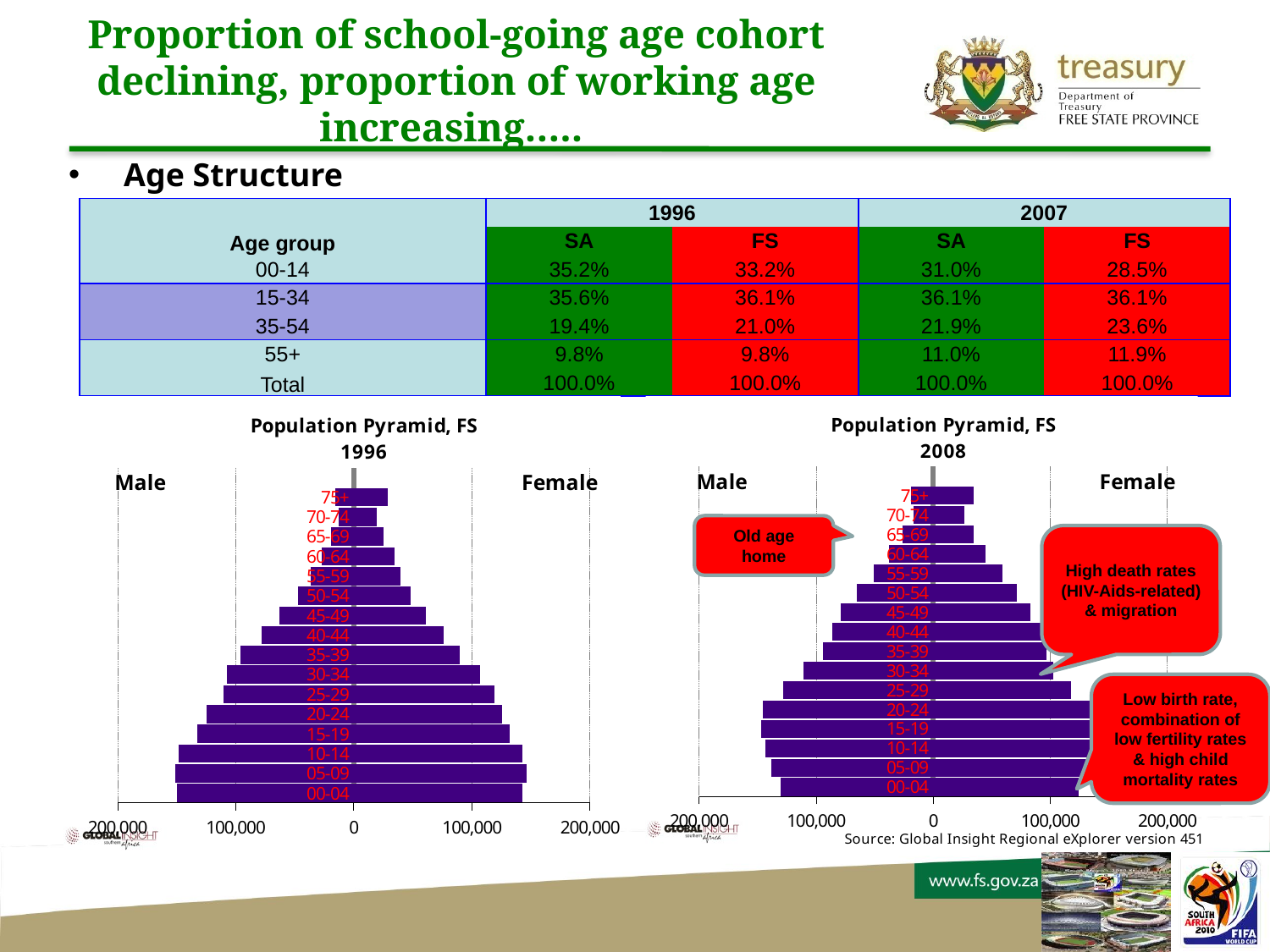
What kind of chart is the 'Population Pyramid, FS 1996' chart? bar chart In the 'Population Pyramid, FS 1996' chart, do the bar lengths generally rise or fall when moving from the youngest age group to the oldest? fall In the 'Population Pyramid, FS 2008' chart, which is larger: the female bar for 10-14 or the female bar for 65-69? 10-14 In the 'Population Pyramid, FS 2008' chart, is the female value for the 60-64 age group greater or less than 100,000? less How many age-group categories does the 'Population Pyramid, FS 2008' chart show? 16 In the 'Population Pyramid, FS 1996' chart, which age group has the shortest bars? 70-74 In the 'Population Pyramid, FS 1996' chart, is the male value for the 00-04 age group greater or less than 100,000? greater In the 'Population Pyramid, FS 2008' chart, is the male value for the 15-19 age group greater or less than 100,000? greater Which side of the 'Population Pyramid, FS 1996' chart shows the Male bars, left or right? left What is the highest value shown on the horizontal axis of the 'Population Pyramid, FS 2008' chart? 200,000 In the 'Population Pyramid, FS 1996' chart, which is larger: the male bar for 00-04 or the male bar for 50-54? 00-04